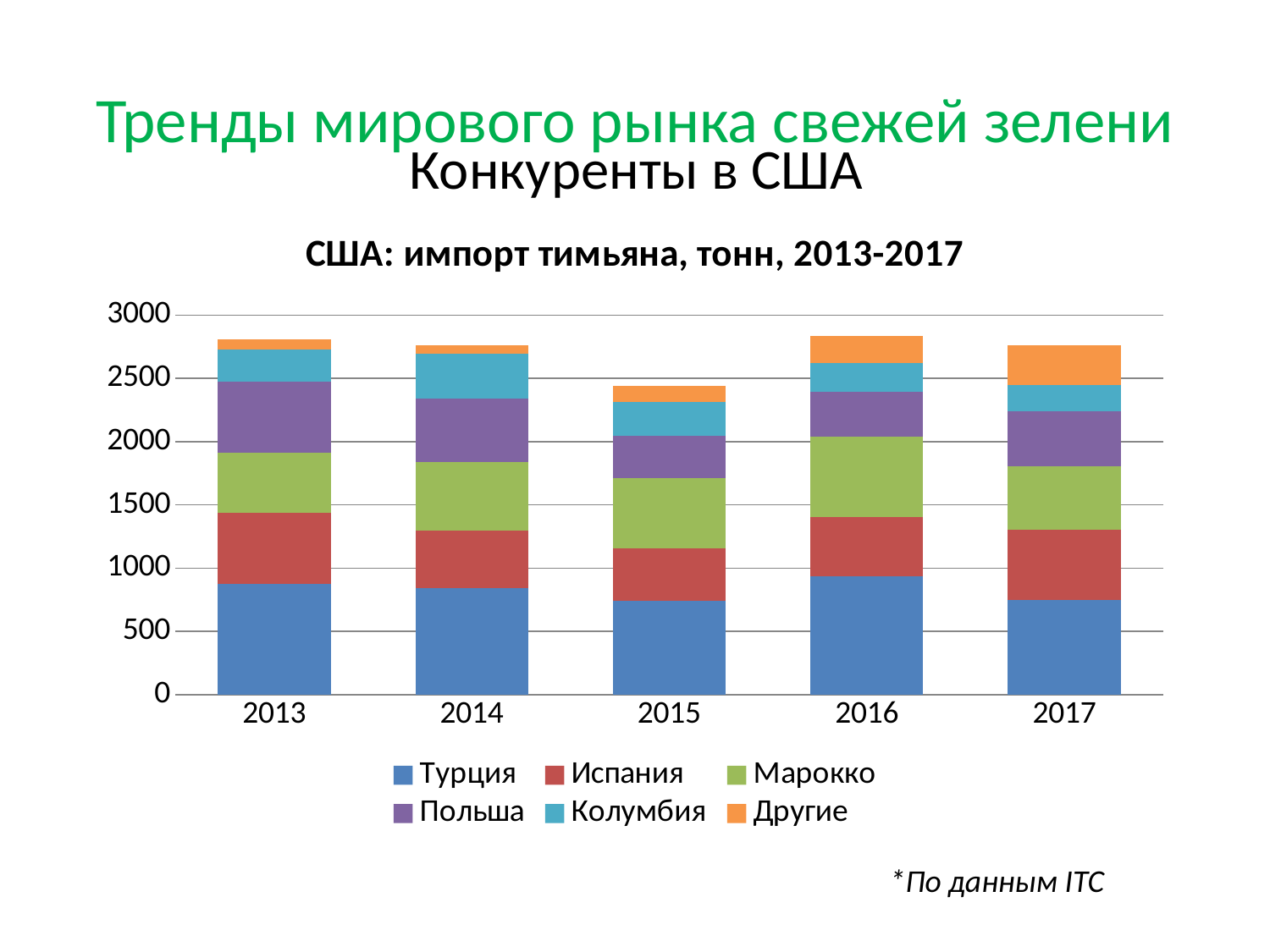
Is the value for Турция in 2016 greater or less than 1000? less Is the total stacked bar for 2015 greater or less than 2500? less Which year has the lowest total stacked bar? 2015 In which year is the Турция segment the largest? 2016 Is the total stacked bar for 2013 greater or less than 2500? greater How many series does the legend list? 6 Which series is shown in orange in the legend? Другие How many years are shown on the x axis of the chart? 5 What kind of chart is shown on the slide? Stacked bar chart Which year has the larger total stacked bar, 2015 or 2016? 2016 What is the title of the chart? США: импорт тимьяна, тонн, 2013-2017